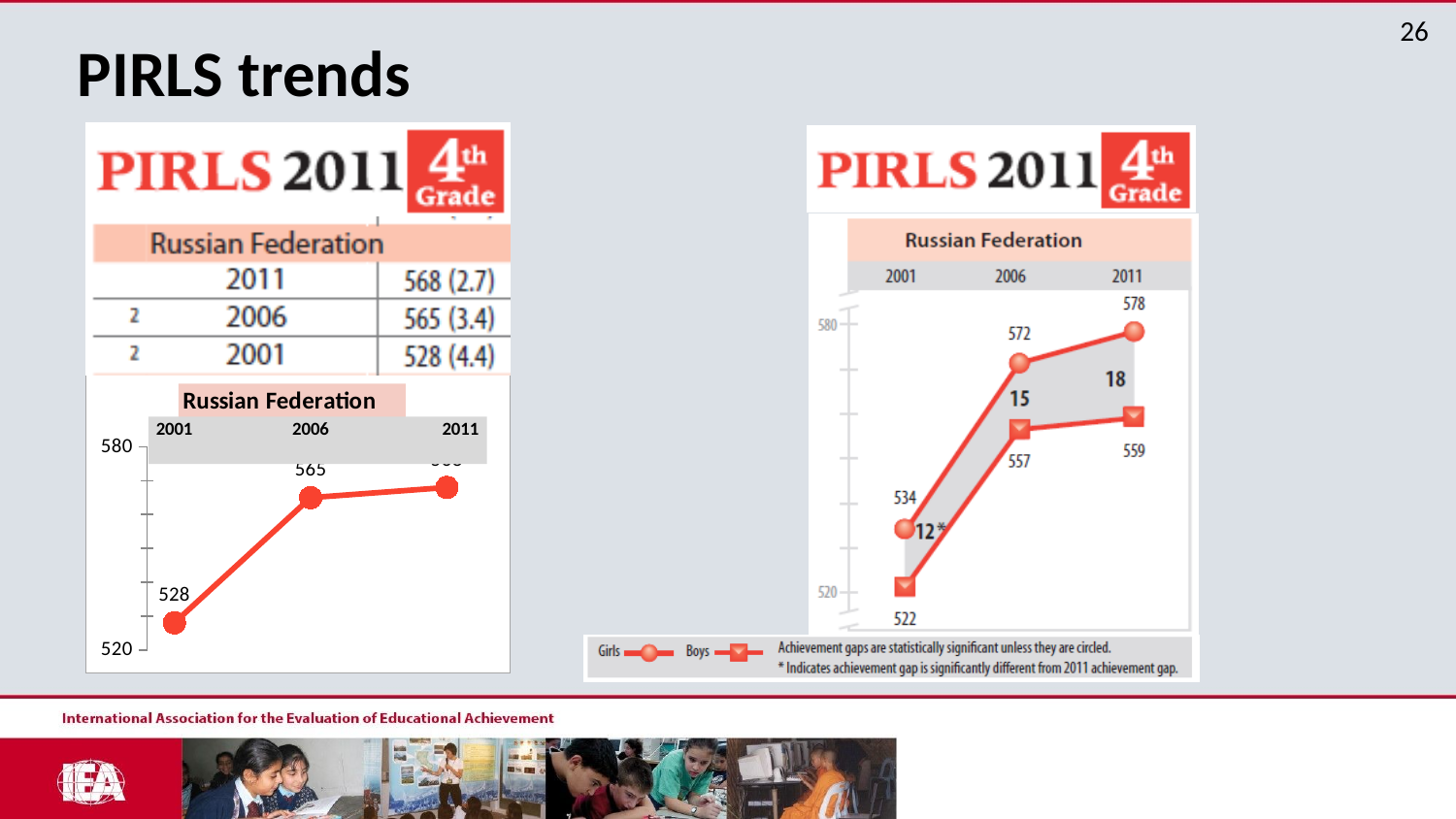
In the left chart, what is the value for 2006? 565 In the left chart, is the value for 2001 greater or less than 540? less In the left chart, do the values rise or fall from 2001 to 2011? rise In the right chart, which series has the higher value in 2011, Girls or Boys? Girls In the right chart, which year has the lowest value for Boys? 2001 In the left chart, what kind of chart is shown? line chart In the right chart, what is the difference between Girls and Boys in 2006? 15 In the left chart, what is the value for 2001? 528 In the right chart, what is the value for Boys in 2001? 522 In the right chart, how many series does the legend list? 2 In the right chart, what is the value for Girls in 2011? 578 In the left chart, how many years are plotted? 3